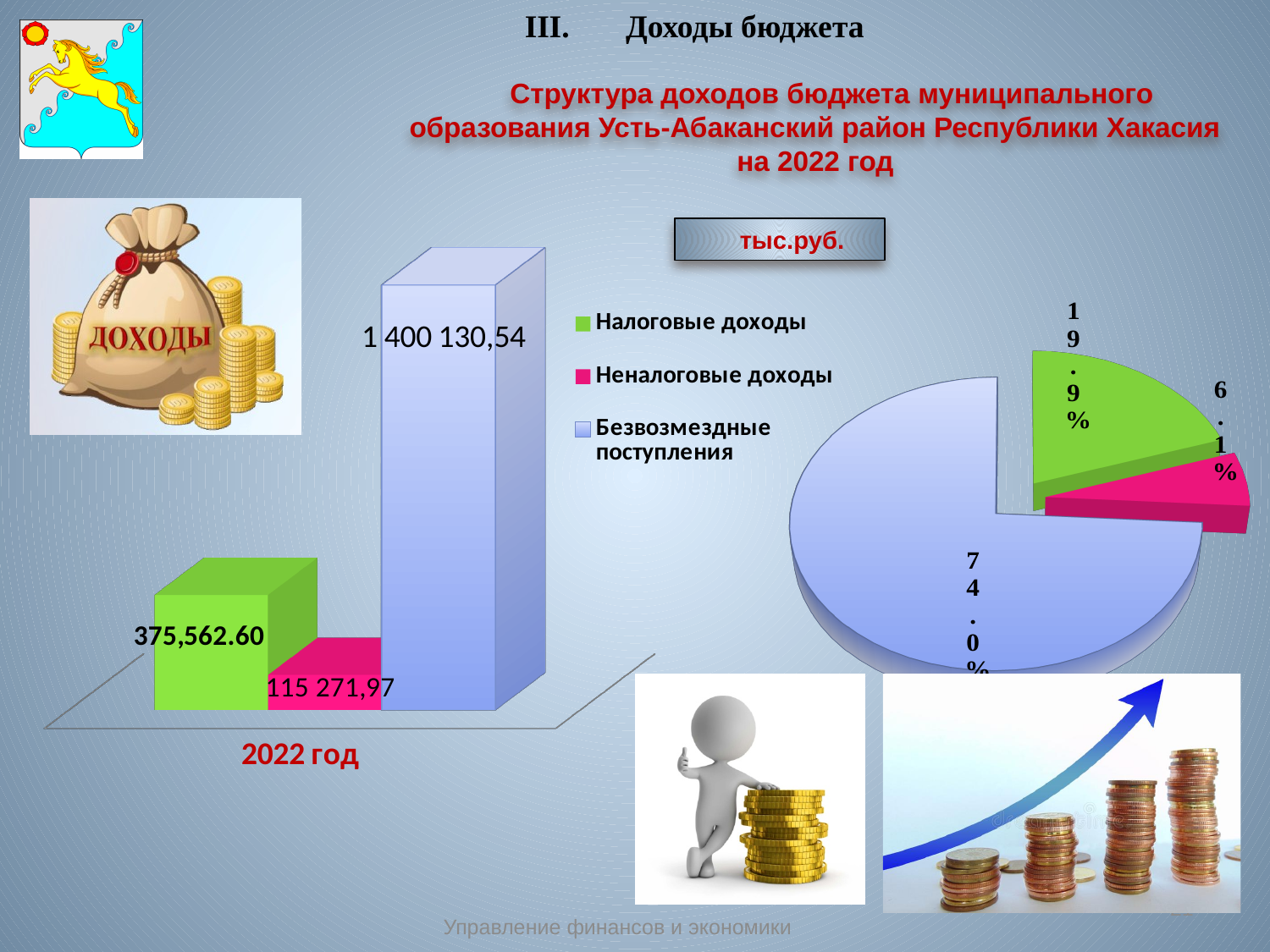
On the pie chart, what share does the blue slice (Безвозмездные поступления) have? 74.0% What kind of chart is the chart on the left side of the slide? Bar chart On the bar chart, which series has the highest value? Безвозмездные поступления On the pie chart, what share does the pink slice (Неналоговые доходы) have? 6.1% On the bar chart, what is the value for Налоговые доходы? 375,562.60 On the bar chart, what is the value for Неналоговые доходы? 115 271,97 On the pie chart, what share does the green slice (Налоговые доходы) have? 19.9% What kind of chart is the chart on the right side of the slide? Pie chart On the bar chart, which series has the lowest value? Неналоговые доходы How many series does the legend of the bar chart list? 3 On the bar chart, which is larger: Налоговые доходы or Неналоговые доходы? Налоговые доходы On the bar chart, what is the value for Безвозмездные поступления? 1 400 130,54